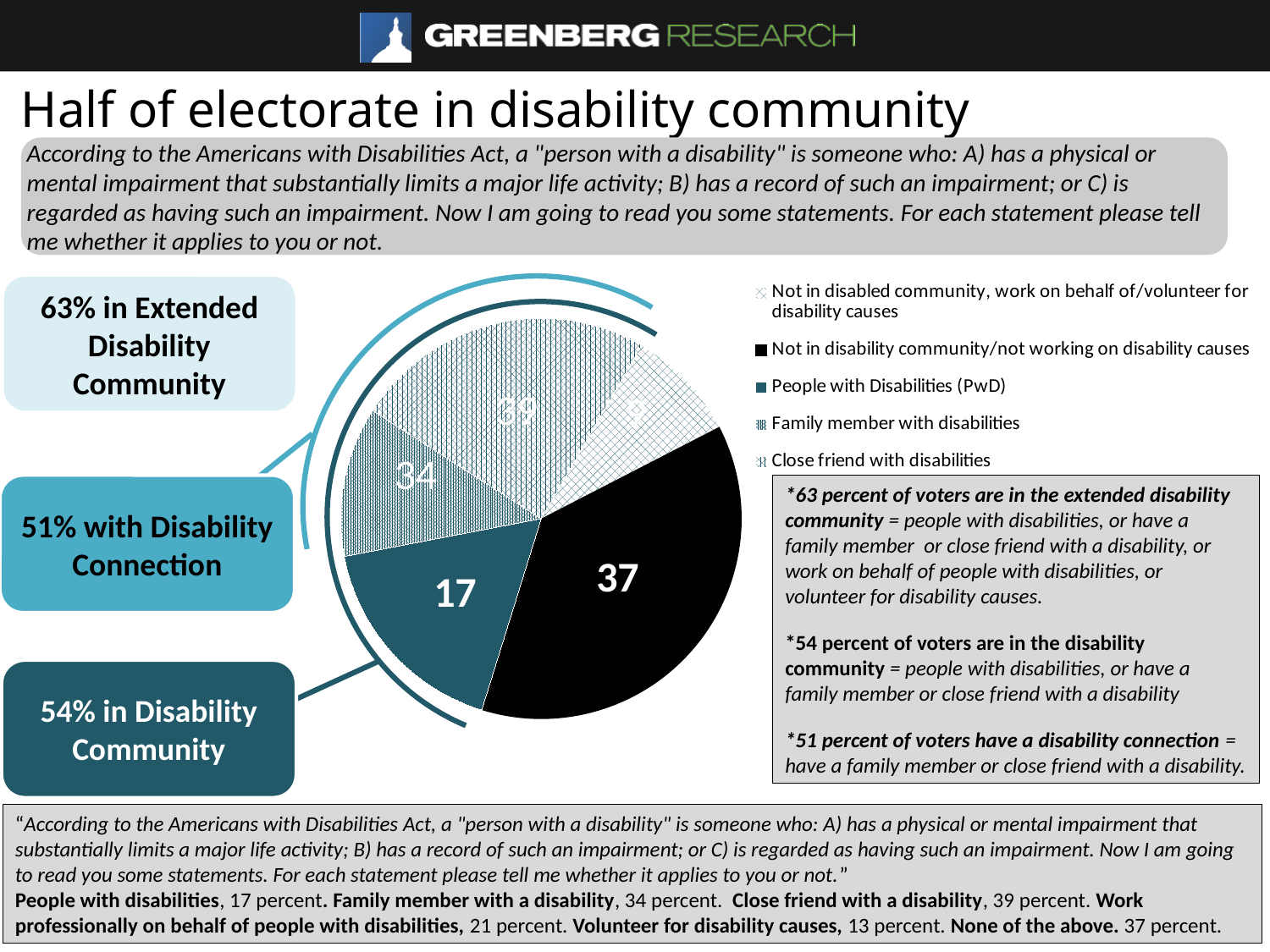
Which is larger: the value for 'Not in disability community/not working on disability causes' or the value for 'People with Disabilities (PwD)'? Not in disability community/not working on disability causes What value is labelled on the slice for 'Not in disability community/not working on disability causes'? 37 What is the difference between the value for 'Close friend with disabilities' and the value for 'Family member with disabilities'? 5 What value is labelled on the slice for 'Family member with disabilities'? 34 What value is labelled on the slice for 'People with Disabilities (PwD)'? 17 What colour is the slice for 'Not in disability community/not working on disability causes'? Black How many entries does the chart's legend list? 5 What kind of chart is shown on the slide? Pie chart What value is labelled on the slice for 'Close friend with disabilities'? 39 How many slices does the pie chart have? 5 What is the difference between the value for 'Not in disability community/not working on disability causes' and the value for 'People with Disabilities (PwD)'? 20 Which is larger: the value for 'Family member with disabilities' or the value for 'People with Disabilities (PwD)'? Family member with disabilities